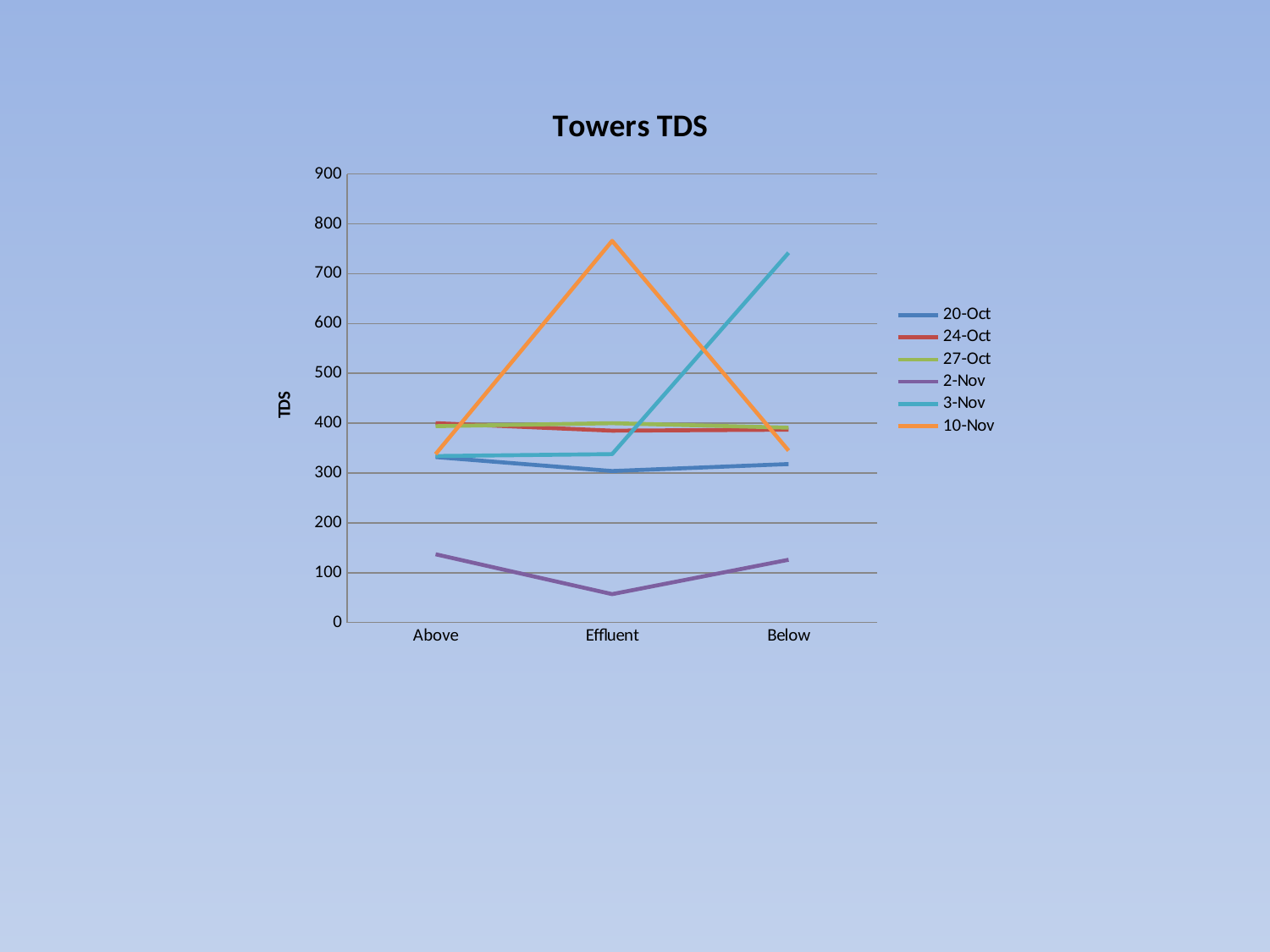
What is the title of the chart? Towers TDS Is the value for 3-Nov at Below greater or less than 700? greater At Above, which is larger: the value for 20-Oct or the value for 2-Nov? 20-Oct How many series does the legend list? 6 Does the 2-Nov line rise or fall from Above to Effluent? fall Is the value for 10-Nov at Effluent greater or less than 700? greater Which series has the lowest value at Effluent? 2-Nov Which series has the highest value at Below? 3-Nov Is the value for 2-Nov at Effluent greater or less than 100? less What kind of chart is shown on the slide? line chart Which series has the highest value at Effluent? 10-Nov How many categories are shown on the x axis? 3